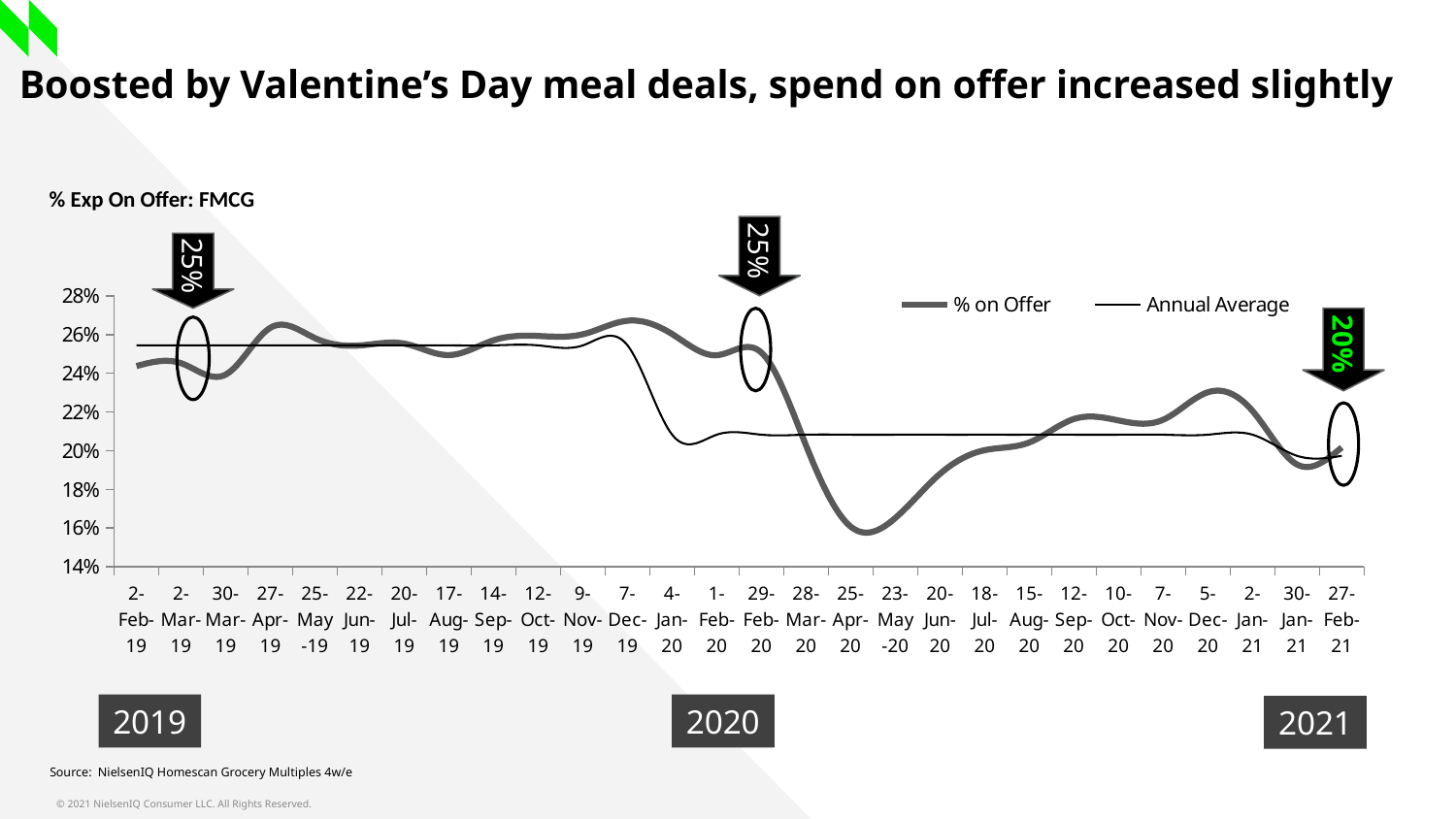
What value is annotated for % on Offer at 2-Mar-19? 25% How many series does the legend list? 2 Which is larger, the % on Offer value at 29-Feb-20 or at 28-Mar-20? 29-Feb-20 What value is annotated for % on Offer at 29-Feb-20? 25% At which date is the % on Offer line at its lowest? 25-Apr-20 What kind of chart is shown on the slide? line chart How many dates are shown on the x axis? 28 What are the two series named in the legend? % on Offer and Annual Average What value is annotated for % on Offer at 27-Feb-21? 20% Does the % on Offer line rise or fall between 29-Feb-20 and 25-Apr-20? fall What is the title of the chart? % Exp On Offer: FMCG Is the % on Offer value at 25-Apr-20 greater or less than 18%? less